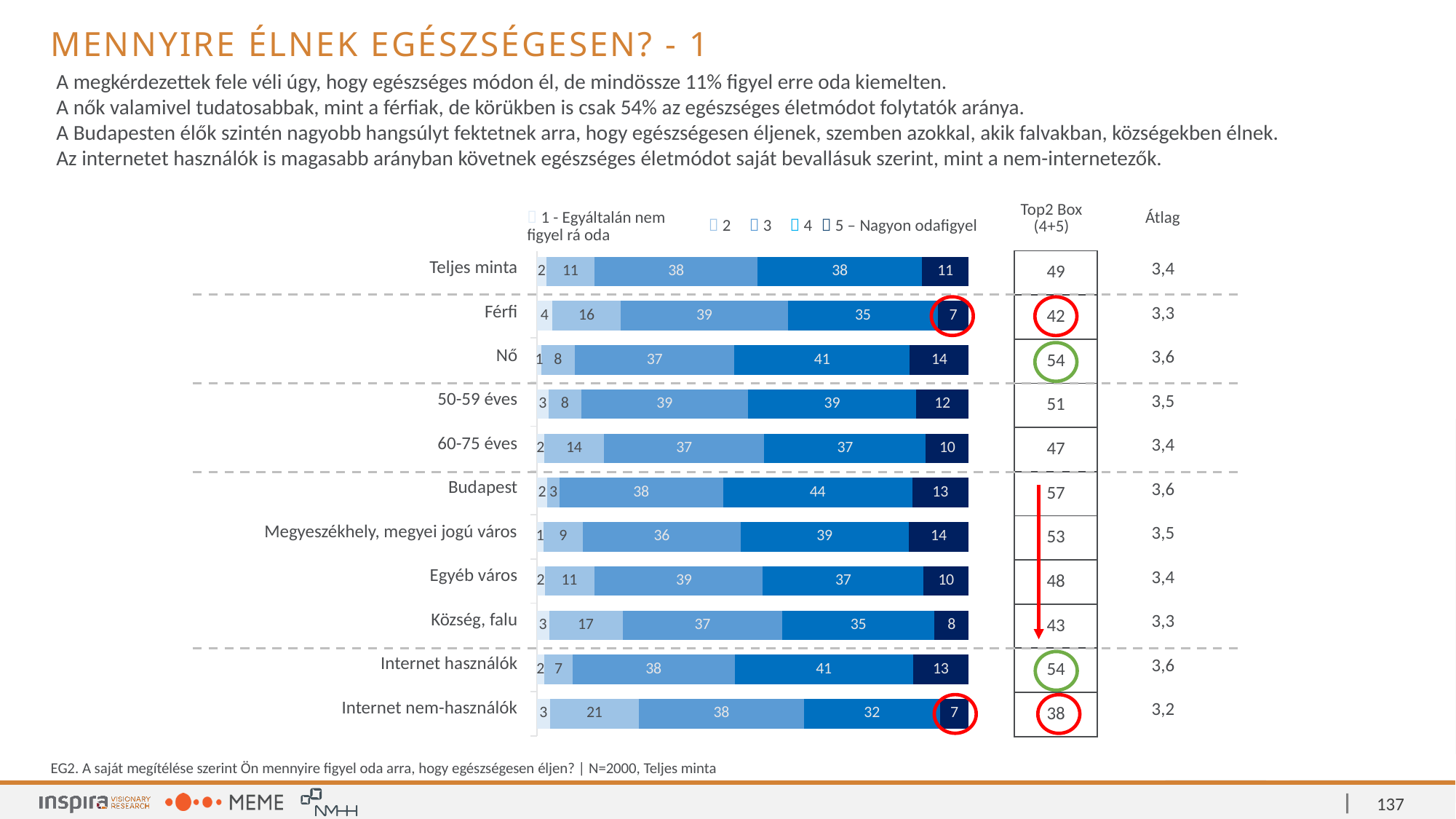
What is the value of the "5 – Nagyon odafigyel" segment for Nő? 14 What is the value of the "4" segment for Budapest? 44 Which has a larger "3" segment value, Férfi or Nő? Férfi What is the value of the "2" segment for Internet nem-használók? 21 Which category has the highest value for the "4" segment? Budapest How many categories (rows) does the chart show? 11 What kind of chart is shown on the slide? bar chart How many series does the legend list? 5 Which category has the lowest value for the "4" segment? Internet nem-használók What is the Top2 Box (4+5) value shown for Budapest? 57 What is the total of the stacked bar for Teljes minta? 100 What is the difference between the "4" segment values for Nő and Férfi? 6